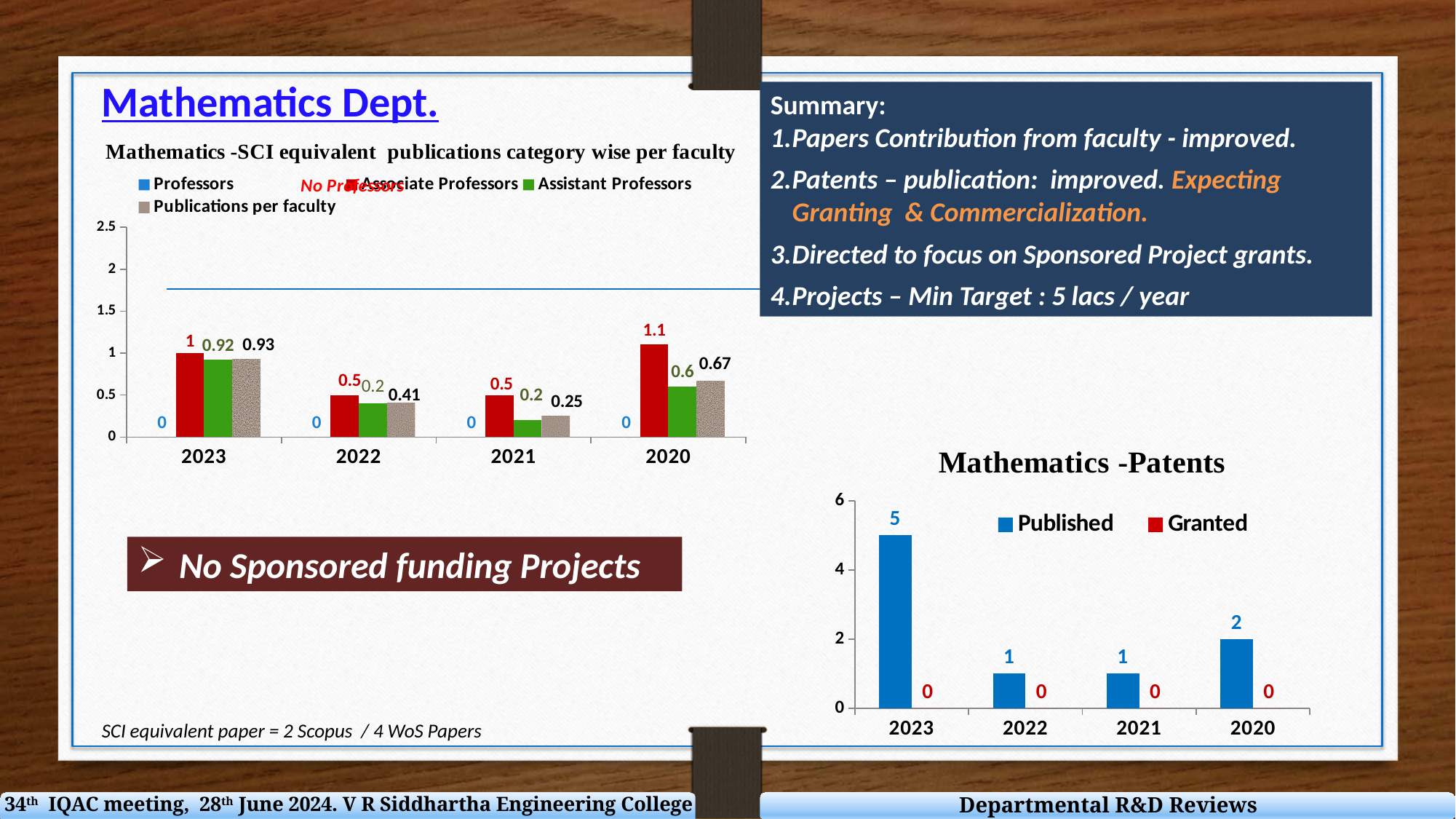
In the 'Mathematics -SCI equivalent publications category wise per faculty' chart, what is the value for Assistant Professors in 2023? 0.92 In the 'Mathematics -SCI equivalent publications category wise per faculty' chart, how many series does the legend list? 4 In the 'Mathematics -Patents' chart, how many years are shown on the x axis? 4 In the 'Mathematics -SCI equivalent publications category wise per faculty' chart, what is the difference between the Associate Professors values for 2020 and 2022? 0.6 In the 'Mathematics -Patents' chart, how many patents were published in 2023? 5 In the 'Mathematics -SCI equivalent publications category wise per faculty' chart, what is the Publications per faculty value for 2022? 0.41 In the 'Mathematics -Patents' chart, which year has the highest Published value? 2023 In the 'Mathematics -SCI equivalent publications category wise per faculty' chart, which year has the highest Publications per faculty value? 2023 In the 'Mathematics -SCI equivalent publications category wise per faculty' chart, what is the value for Associate Professors in 2020? 1.1 In the 'Mathematics -Patents' chart, what is the difference between the Published values for 2023 and 2020? 3 What kind of chart is the 'Mathematics -Patents' chart? Bar chart In the 'Mathematics -SCI equivalent publications category wise per faculty' chart, which year has the lowest Publications per faculty value? 2021